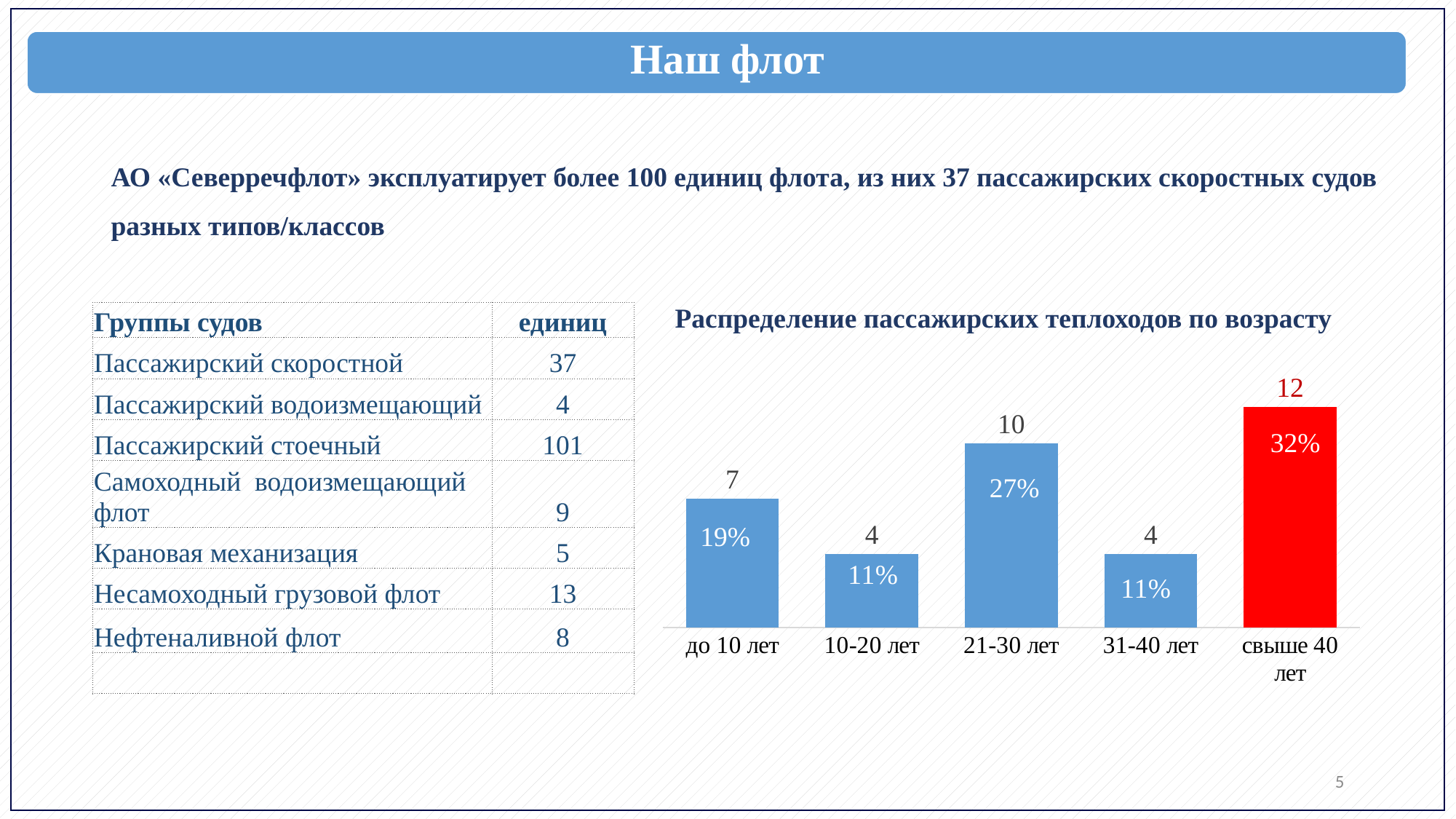
How many age categories are shown in the chart? 5 What kind of chart is "Распределение пассажирских теплоходов по возрасту"? bar chart Which is larger: the value for "до 10 лет" or the value for "10-20 лет"? до 10 лет Which bar in the chart is coloured red rather than blue? свыше 40 лет Which age category has the highest value in the chart? свыше 40 лет What is the difference between the values for "свыше 40 лет" and "21-30 лет"? 2 Which age categories share the lowest value in the chart? 10-20 лет and 31-40 лет What percentage is shown on the "10-20 лет" bar? 11% What percentage is shown on the "21-30 лет" bar? 27% What is the value for the "до 10 лет" category in the chart "Распределение пассажирских теплоходов по возрасту"? 7 What is the difference between the values for "до 10 лет" and "31-40 лет"? 3 What is the value for the "свыше 40 лет" category? 12